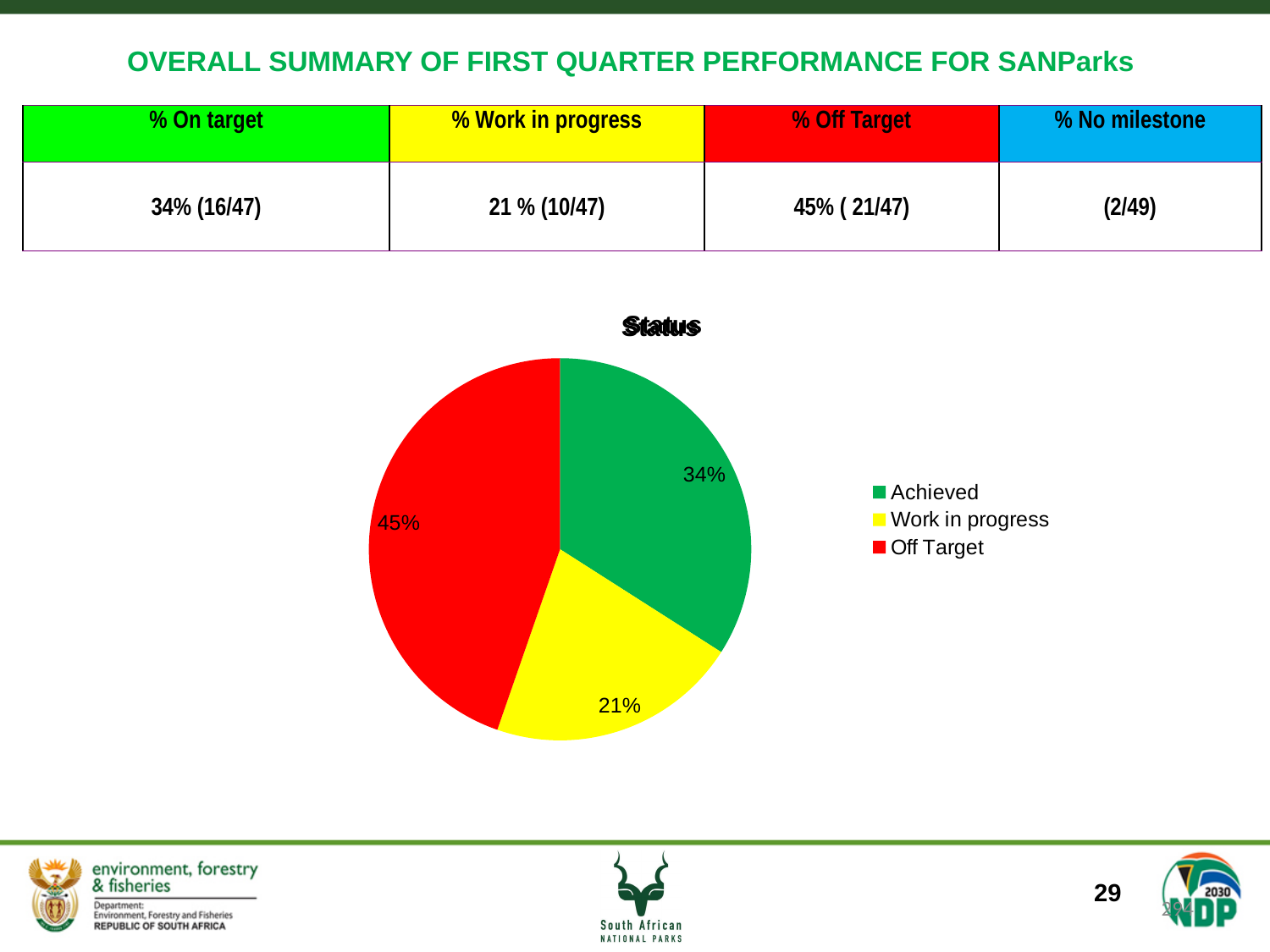
Which slice is larger, Achieved or Work in progress? Achieved What is the difference in percentage points between the Off Target slice and the Achieved slice? 11 How many entries does the legend list? 3 Which category has the smallest slice of the pie? Work in progress What colour is the Off Target slice in the pie chart? red How many slices does the pie chart have? 3 What percentage of the pie is labelled for Off Target? 45% Which category has the largest slice of the pie? Off Target What percentage of the pie is labelled for Work in progress? 21% What percentage of the pie is labelled for Achieved? 34% What is the title of the chart? Status What kind of chart is shown on the slide? pie chart